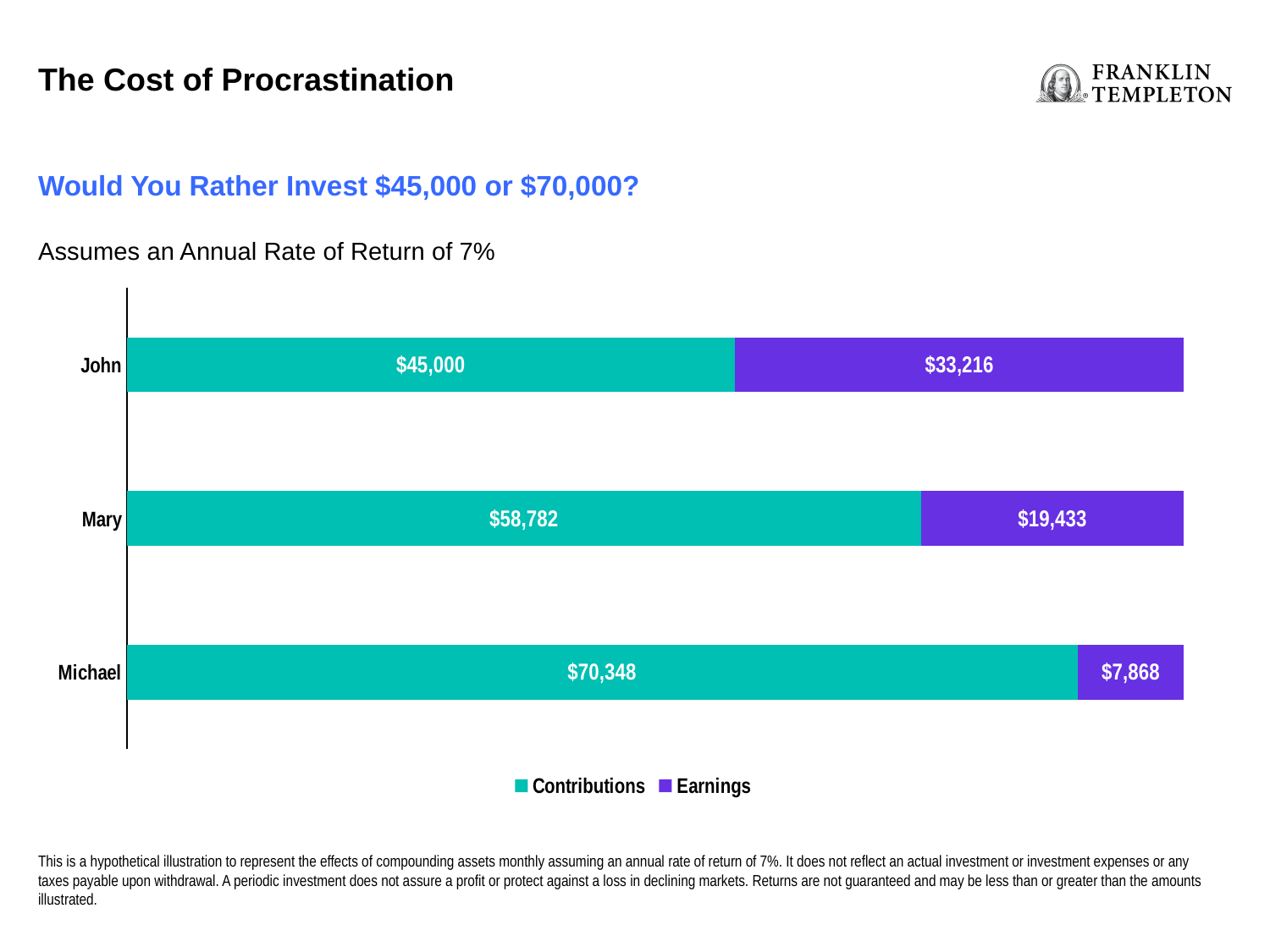
What kind of chart is shown on the slide? Stacked bar chart Which person has the highest Earnings? John Which series is shown in purple in the legend? Earnings How many people are shown on the chart? 3 What is the total of John's bar (Contributions plus Earnings)? $78,216 What is the Contributions value for Michael? $70,348 Which person has the lowest Contributions? John What is the Contributions value for John? $45,000 Who has larger Earnings, Mary or Michael? Mary What is the Earnings value for Mary? $19,433 What is the difference between Michael's Contributions and John's Contributions? $25,348 How many series does the legend list? 2